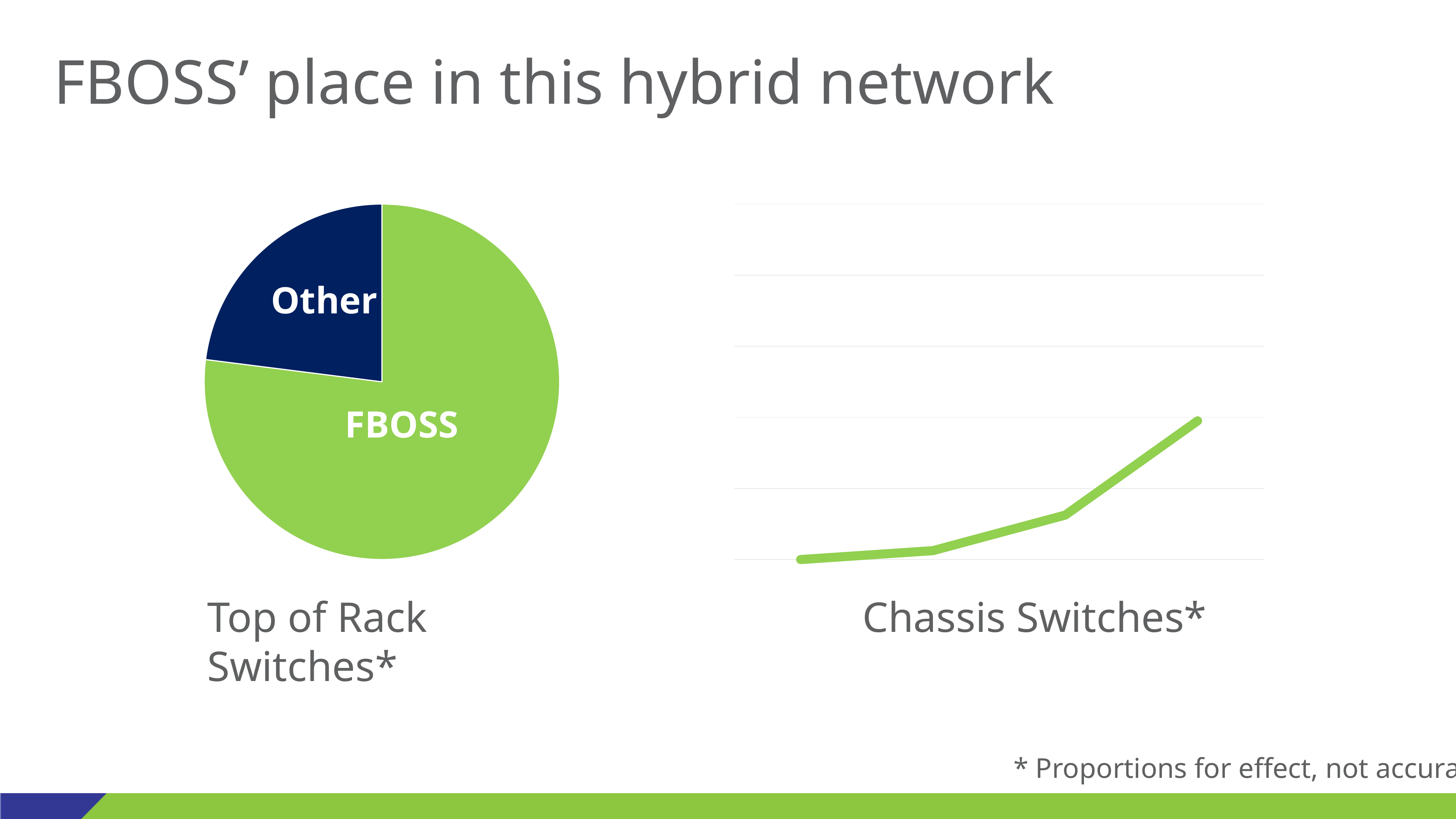
In the Top of Rack Switches pie chart, which slice is the smallest? Other What kind of chart is the Chassis Switches chart on the right? line chart In the Top of Rack Switches pie chart, how many slices are there? 2 In the Chassis Switches line chart, how many lines are plotted? 1 In the Top of Rack Switches pie chart, which slice is larger, FBOSS or Other? FBOSS What kind of chart is the Top of Rack Switches chart on the left? pie chart In the Top of Rack Switches pie chart, what colour is the Other slice? dark blue In the Top of Rack Switches pie chart, which slice is the largest? FBOSS In the Chassis Switches line chart, do the values rise or fall along the x axis? rise In the Top of Rack Switches pie chart, what colour is the FBOSS slice? green In the Chassis Switches line chart, how many data points are plotted on the line? 4